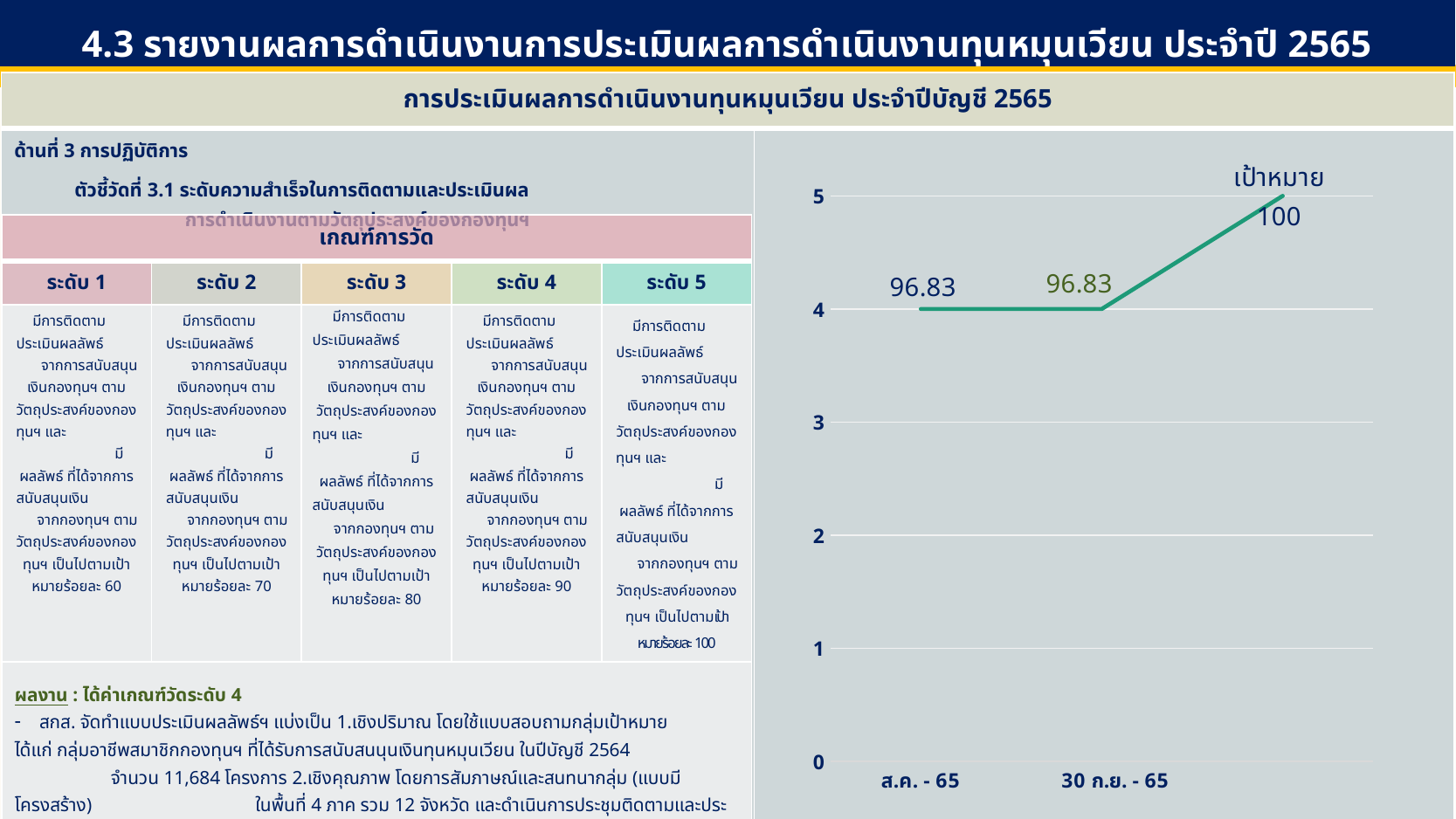
What is the difference between the เป้าหมาย value and the 30 ก.ย. - 65 value on the chart? 3.17 Is the line at 30 ก.ย. - 65 greater or less than 3 on the y-axis? greater What is the highest tick value shown on the chart's y-axis? 5 What value is labelled on the chart for เป้าหมาย? 100 Does the line rise or fall from 30 ก.ย. - 65 to เป้าหมาย? rise On the y-axis scale, what level does the line sit at for ส.ค. - 65? 4 On the y-axis scale, what level does the line reach at เป้าหมาย? 5 How many data points are plotted on the line in the chart? 3 What value is labelled on the chart for ส.ค. - 65? 96.83 What value is labelled on the chart for 30 ก.ย. - 65? 96.83 Which point on the chart has the highest labelled value? เป้าหมาย What type of chart is shown on the right side of the slide? line chart